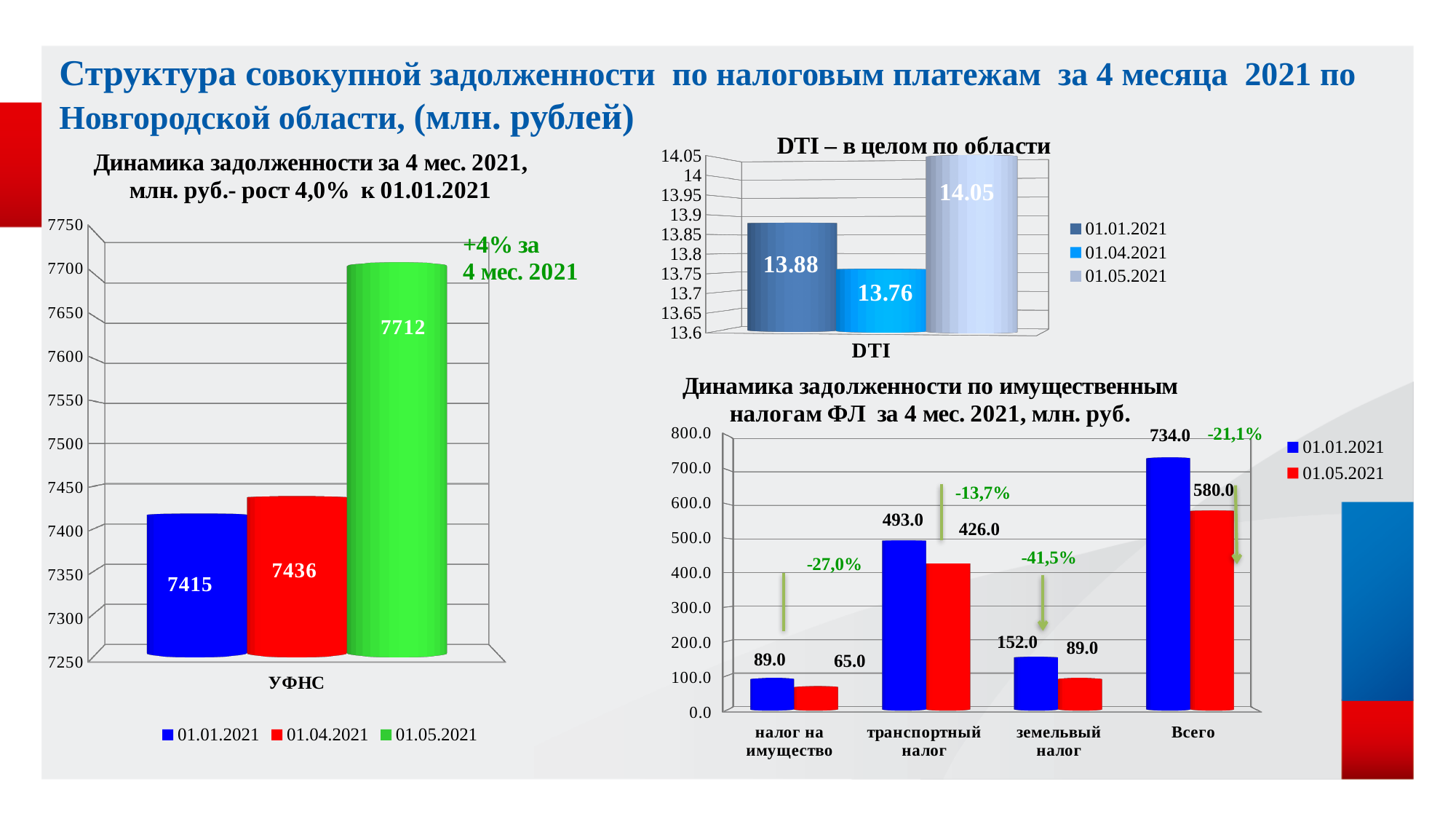
In the bottom-right chart 'Динамика задолженности по имущественным налогам ФЛ', what is the value for транспортный налог on 01.05.2021? 426.0 In the bottom-right chart 'Динамика задолженности по имущественным налогам ФЛ', what is the difference between the 01.01.2021 and 01.05.2021 values for Всего? 154.0 In the left chart 'Динамика задолженности за 4 мес. 2021', what is the value for 01.01.2021? 7415 In the chart 'DTI – в целом по области', what is the value for 01.04.2021? 13.76 In the bottom-right chart 'Динамика задолженности по имущественным налогам ФЛ', how many categories are shown on the x axis? 4 In the chart 'DTI – в целом по области', which series has the highest value? 01.05.2021 In the left chart 'Динамика задолженности за 4 мес. 2021', what is the difference between the 01.05.2021 and 01.04.2021 values? 276 In the left chart 'Динамика задолженности за 4 мес. 2021', what is the value for 01.05.2021? 7712 In the bottom-right chart 'Динамика задолженности по имущественным налогам ФЛ', which is larger: земельный налог on 01.01.2021 or налог на имущество on 01.01.2021? земельный налог on 01.01.2021 What kind of chart is the bottom-right chart 'Динамика задолженности по имущественным налогам ФЛ'? bar chart In the left chart 'Динамика задолженности за 4 мес. 2021', how many series does the legend list? 3 In the chart 'DTI – в целом по области', which series has the lowest value? 01.04.2021